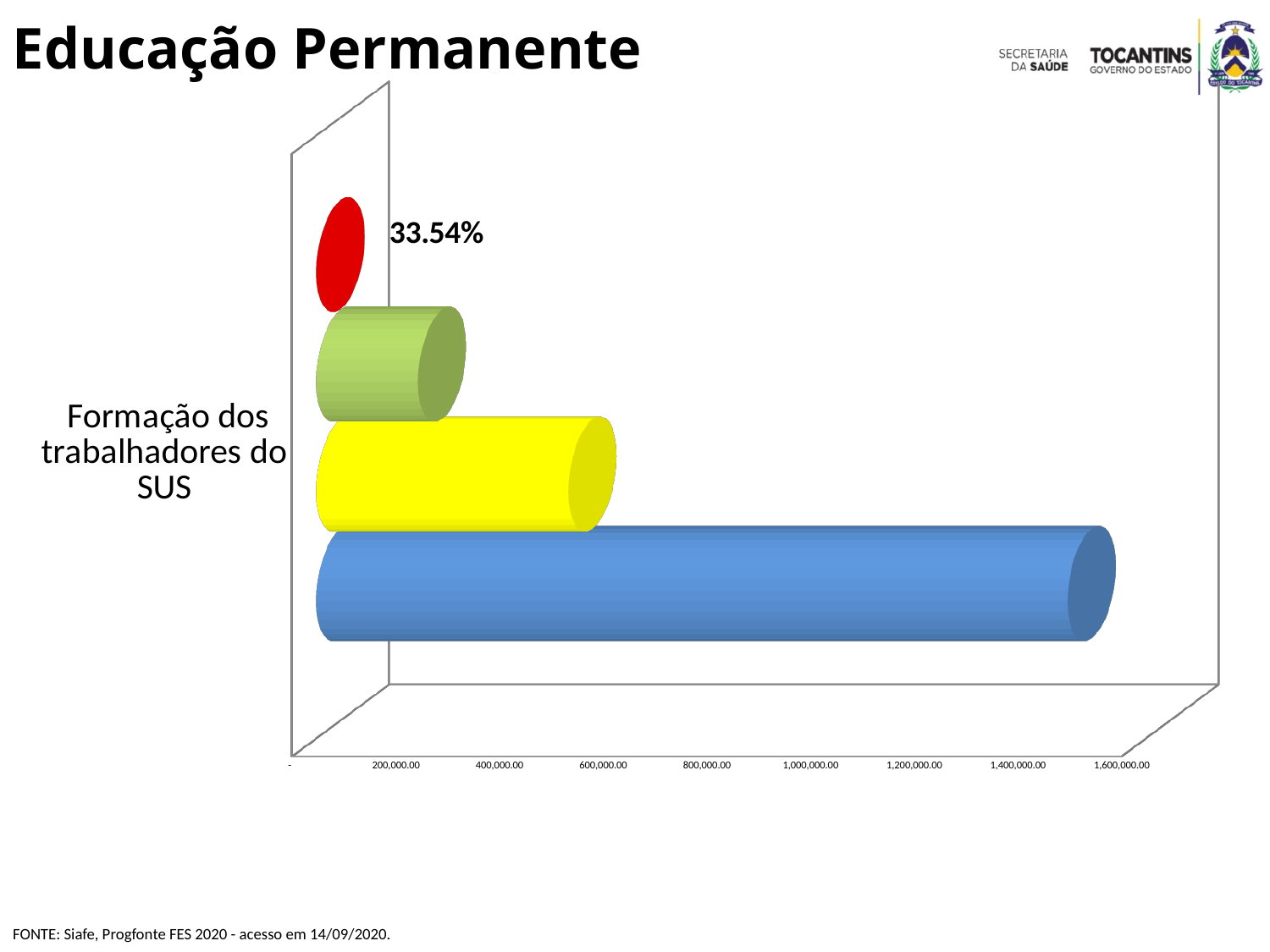
What data label is printed next to the red bar? 33.54% Which coloured bar is the shortest in the chart? red Is the value of the green bar greater or less than 400,000.00? less How many bars are plotted in the chart? 4 How many categories are shown on the vertical axis of the chart? 1 What is the title shown above the chart on the slide? Educação Permanente Which bar is longer, the yellow bar or the green bar? yellow What kind of chart is shown on the slide? bar chart Which coloured bar is the longest in the chart? blue What is the category label shown on the vertical axis of the chart? Formação dos trabalhadores do SUS Is the value of the blue bar greater or less than 1,000,000.00? greater Is the value of the yellow bar greater or less than 800,000.00? less